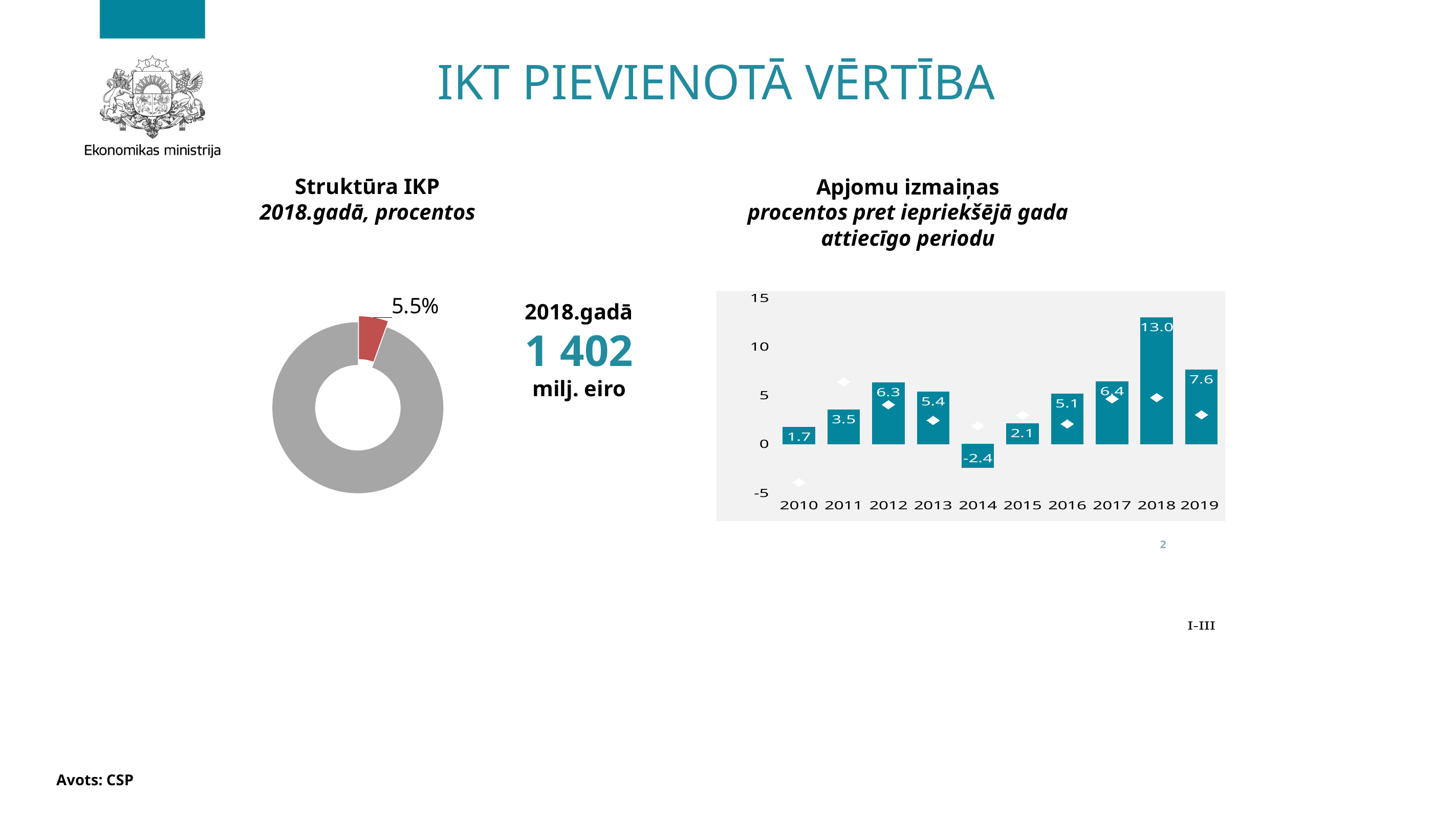
In the 'Apjomu izmaiņas' chart, how many years are shown on the x axis? 10 In the 'Apjomu izmaiņas' chart, what is the value for 2019? 7.6 In the 'Apjomu izmaiņas' chart, do the bar values rise or fall from 2015 to 2018? rise What kind of chart is the 'Struktūra IKP' chart on the left? donut chart In the 'Apjomu izmaiņas' chart, which year has the highest bar? 2018 In the 'Apjomu izmaiņas' chart, which year has the lowest bar? 2014 What kind of chart is the 'Apjomu izmaiņas' chart? combination bar and line chart In the 'Apjomu izmaiņas' chart, what is the value for 2014? -2.4 In the 'Apjomu izmaiņas' chart, which is larger, the value for 2012 or the value for 2013? 2012 In the 'Apjomu izmaiņas' chart, what is the difference between the values for 2018 and 2019? 5.4 In the 'Struktūra IKP' donut chart, what share is shown for the highlighted (red) slice? 5.5% In the 'Apjomu izmaiņas' chart, what is the value for 2018? 13.0